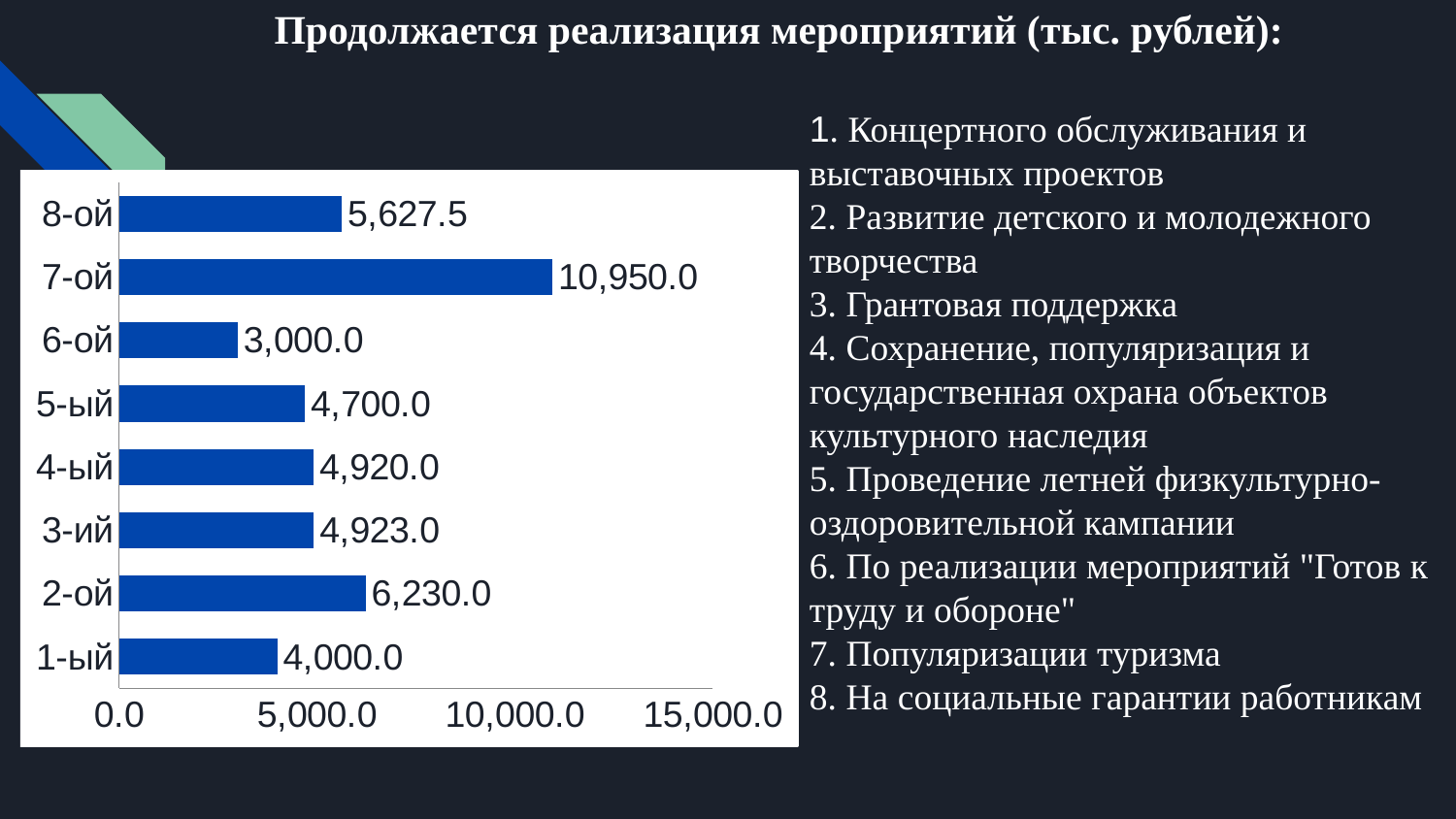
How many categories are shown in the chart? 8 What kind of chart is shown on the slide? bar chart What is the title of the slide above the chart? Продолжается реализация мероприятий (тыс. рублей): What is the value for the 8-ой category? 5,627.5 What is the value for the 7-ой category? 10,950.0 What is the difference between the values for 7-ой and 2-ой? 4,720.0 Which category has the highest value? 7-ой What is the difference between the values for 3-ий and 4-ый? 3.0 Which is larger, the value for 2-ой or the value for 5-ый? 2-ой What is the value for the 1-ый category? 4,000.0 Which category has the lowest value? 6-ой Is the value for 7-ой greater or less than 10,000.0? greater